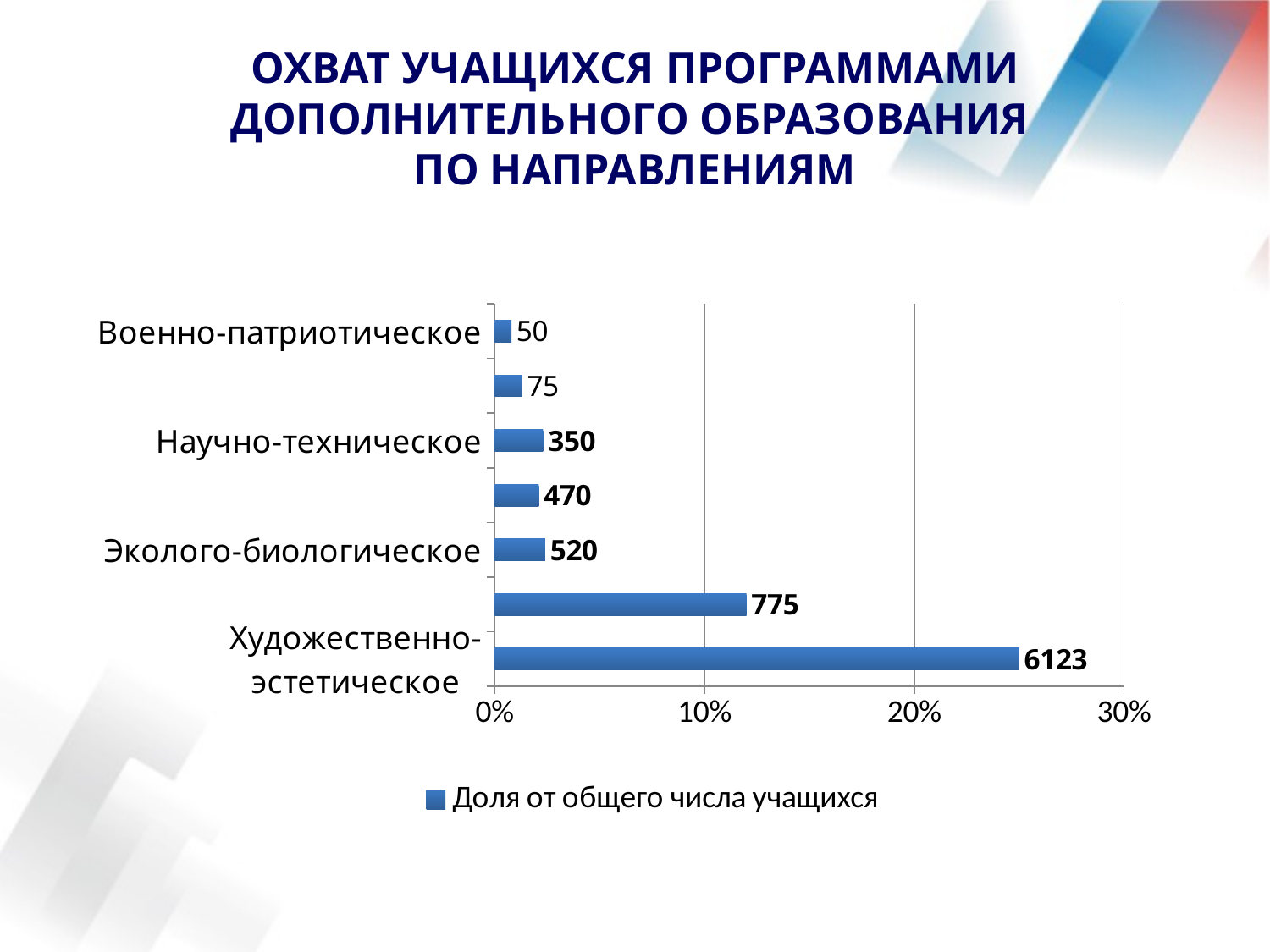
Which is larger, the value for Эколого-биологическое or Научно-техническое? Эколого-биологическое What data label is shown for Художественно-эстетическое? 6123 What data label is shown for Военно-патриотическое? 50 What data label is shown for Эколого-биологическое? 520 What is the difference between the data labels for Эколого-биологическое and Научно-техническое? 170 What kind of chart is shown on the slide? bar chart What is the difference between the data labels for Научно-техническое and Военно-патриотическое? 300 What data label is shown for Научно-техническое? 350 Which category has the lowest value? Военно-патриотическое How many bars are plotted in the chart? 7 Which category has the highest value? Художественно-эстетическое Is the share for Художественно-эстетическое greater or less than 20%? greater